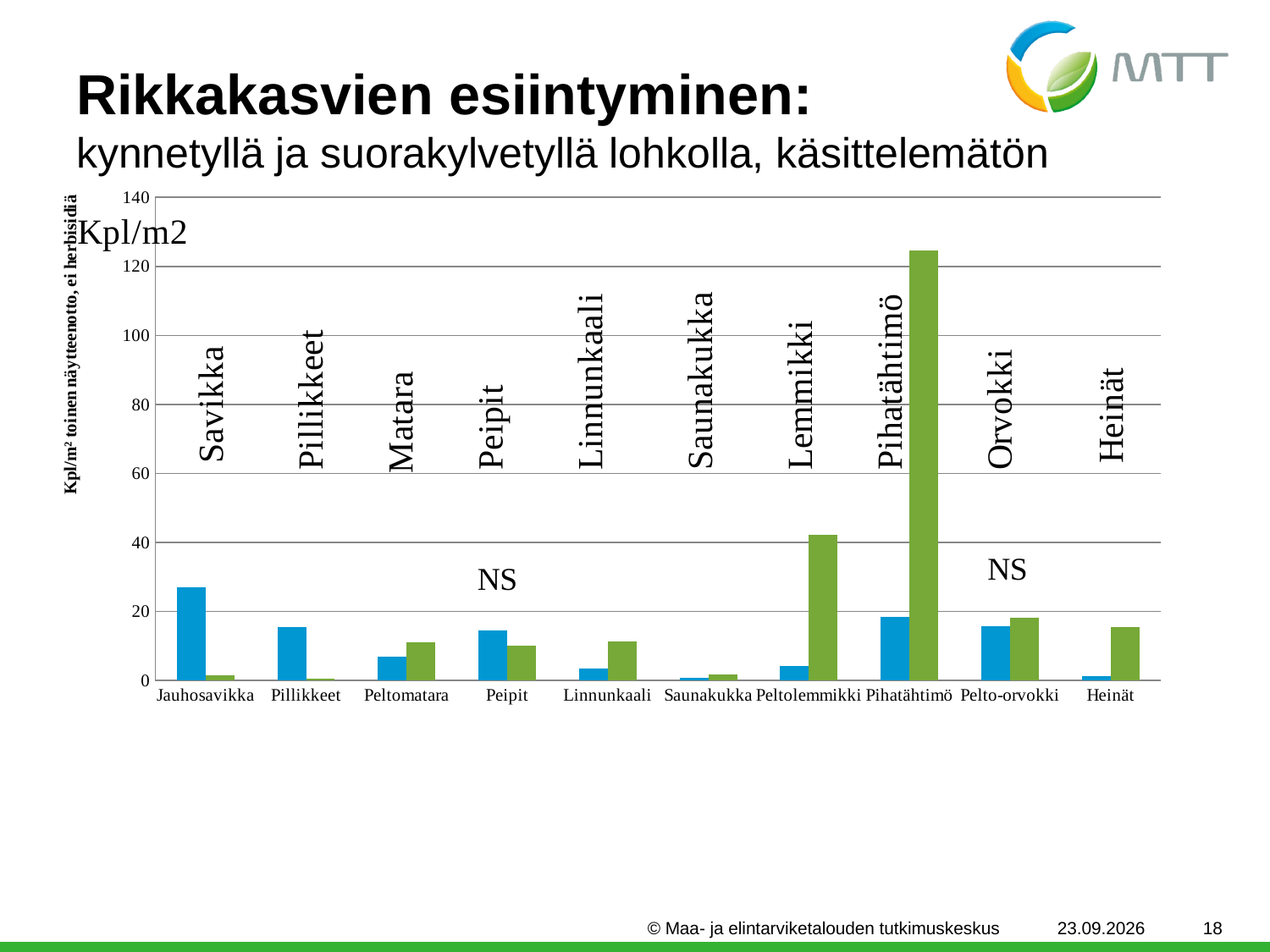
Is the green bar for Pihatähtimö greater or less than 120? greater Is the blue bar for Jauhosavikka greater or less than 20? greater What kind of chart is shown on the slide? bar chart For Peltolemmikki, which bar is taller, the blue one or the green one? green How many categories are shown on the x axis of the chart? 10 What unit is written at the top of the y axis of the chart? Kpl/m2 Which category has the tallest bar in the chart? Pihatähtimö What is the highest value shown on the y axis of the chart? 140 For Jauhosavikka, which bar is taller, the blue one or the green one? blue Which category has the tallest blue bar? Jauhosavikka Is the green bar for Peltolemmikki greater or less than 20? greater